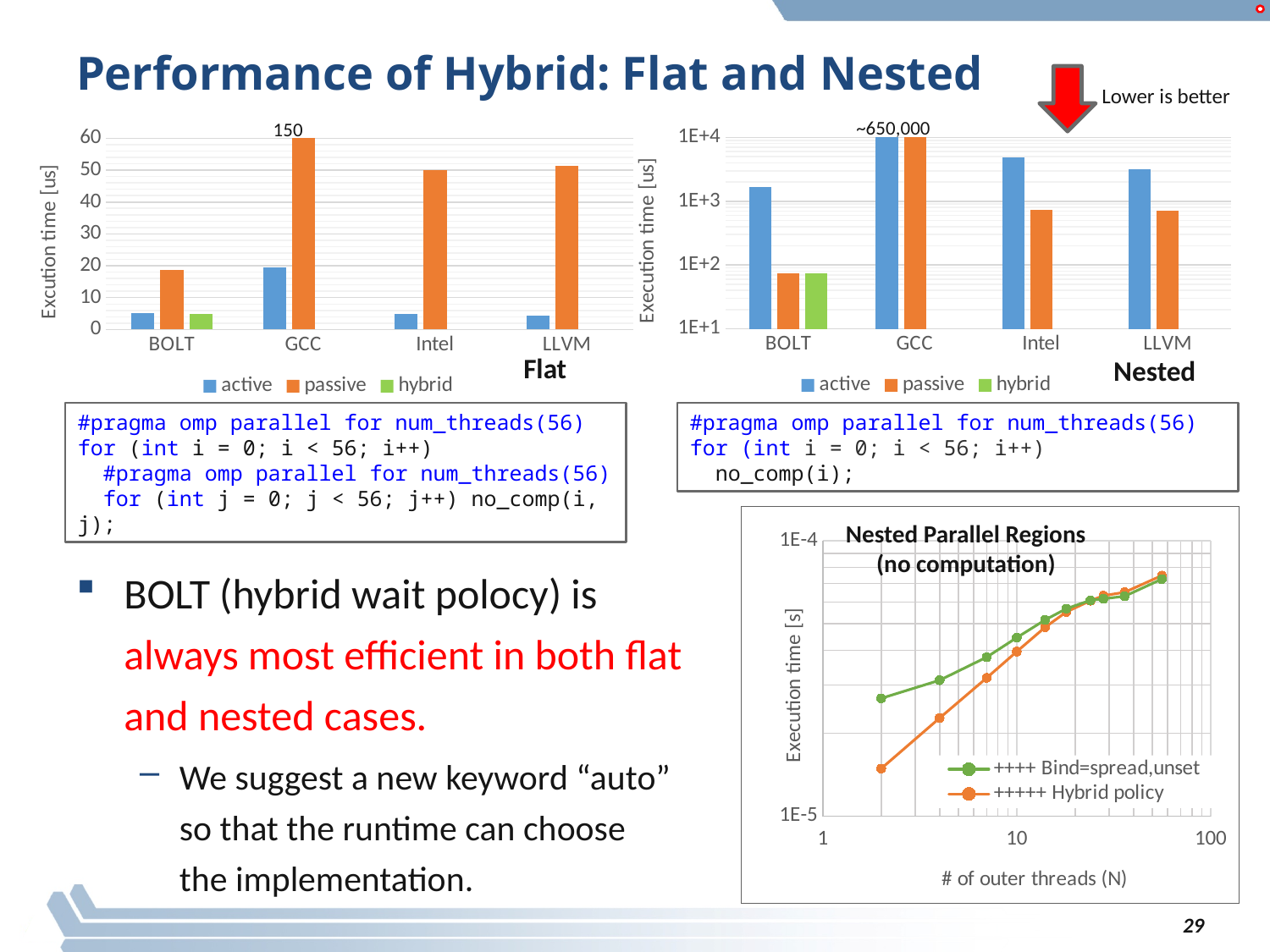
How many series does the legend of the Flat chart list? 3 In the Nested Parallel Regions (no computation) chart, do the values rise or fall as the number of outer threads increases? rise In the Flat chart, is the passive value for BOLT greater or less than 10? greater In the Nested chart, for which category is a hybrid bar plotted? BOLT In the Nested chart, is the passive value for Intel greater or less than 1E+3? less How many series does the legend of the Nested Parallel Regions (no computation) chart list? 2 In the Flat chart, which category has the highest passive value? GCC In the Nested chart, is the active value for BOLT greater or less than 1E+3? greater In the Flat chart, what is the value of the passive bar for GCC? 150 What kind of chart is the Flat chart? bar chart In the Flat chart, which is larger for BOLT: the active value or the passive value? passive How many categories are shown on the x axis of the Flat chart? 4